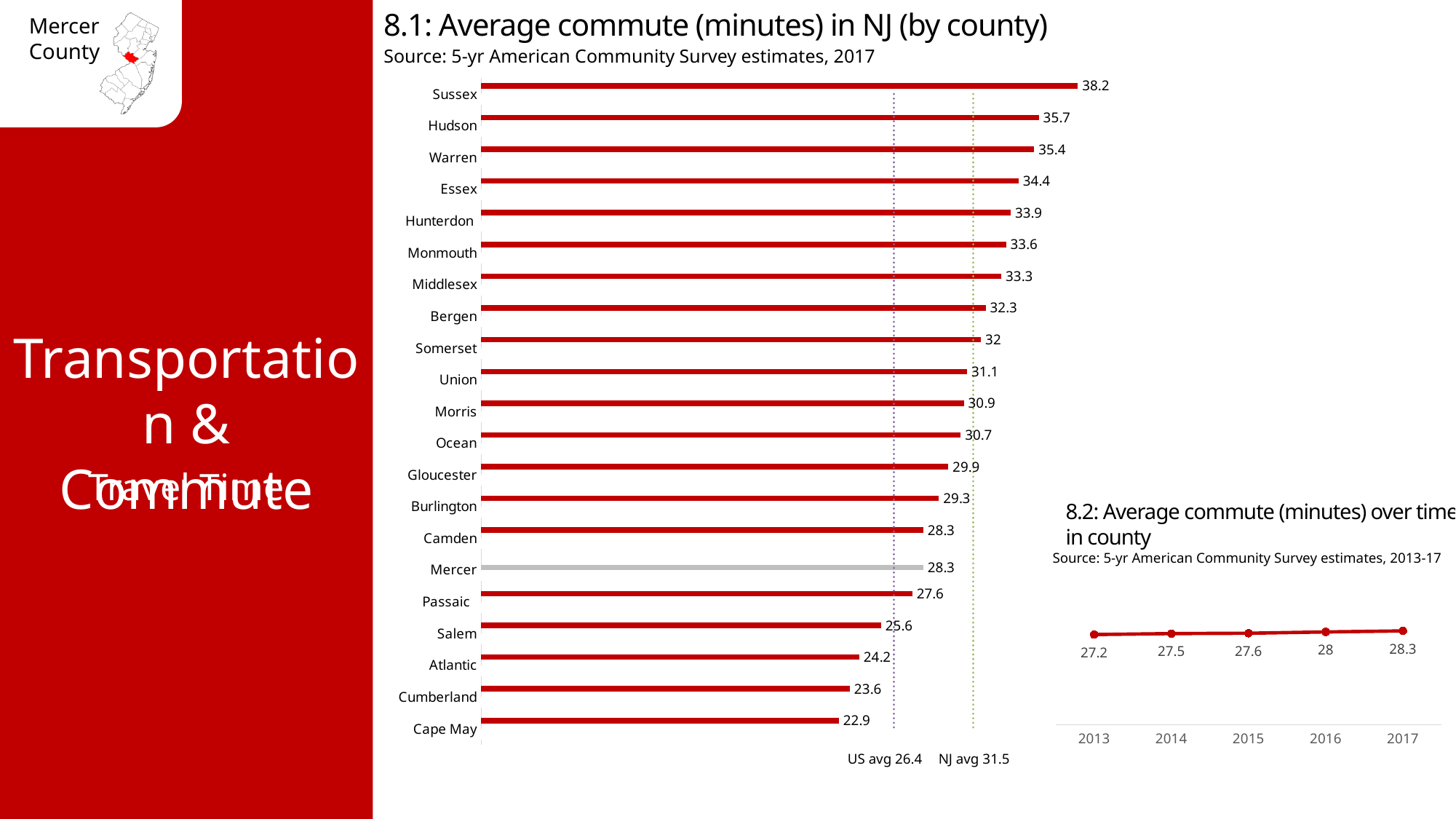
In chart 8.1 (Average commute in NJ by county), what is the average commute for Bergen? 32.3 In chart 8.1 (Average commute in NJ by county), which has a longer average commute, Hudson or Warren? Hudson In chart 8.1 (Average commute in NJ by county), which county has the lowest average commute? Cape May In chart 8.2 (Average commute over time in county), what is the value for 2015? 27.6 In chart 8.1 (Average commute in NJ by county), which county has the highest average commute? Sussex In chart 8.2 (Average commute over time in county), do the values rise or fall from 2013 to 2017? Rise In chart 8.1 (Average commute in NJ by county), what is the difference between Sussex and Cape May? 15.3 In chart 8.1 (Average commute in NJ by county), how many counties are shown? 21 In chart 8.2 (Average commute over time in county), what is the difference between 2017 and 2013? 1.1 What kind of chart is chart 8.1 (Average commute in NJ by county)? Bar chart In chart 8.1 (Average commute in NJ by county), what is the average commute for Mercer? 28.3 In chart 8.1 (Average commute in NJ by county), what NJ average value is marked by the dotted line? 31.5